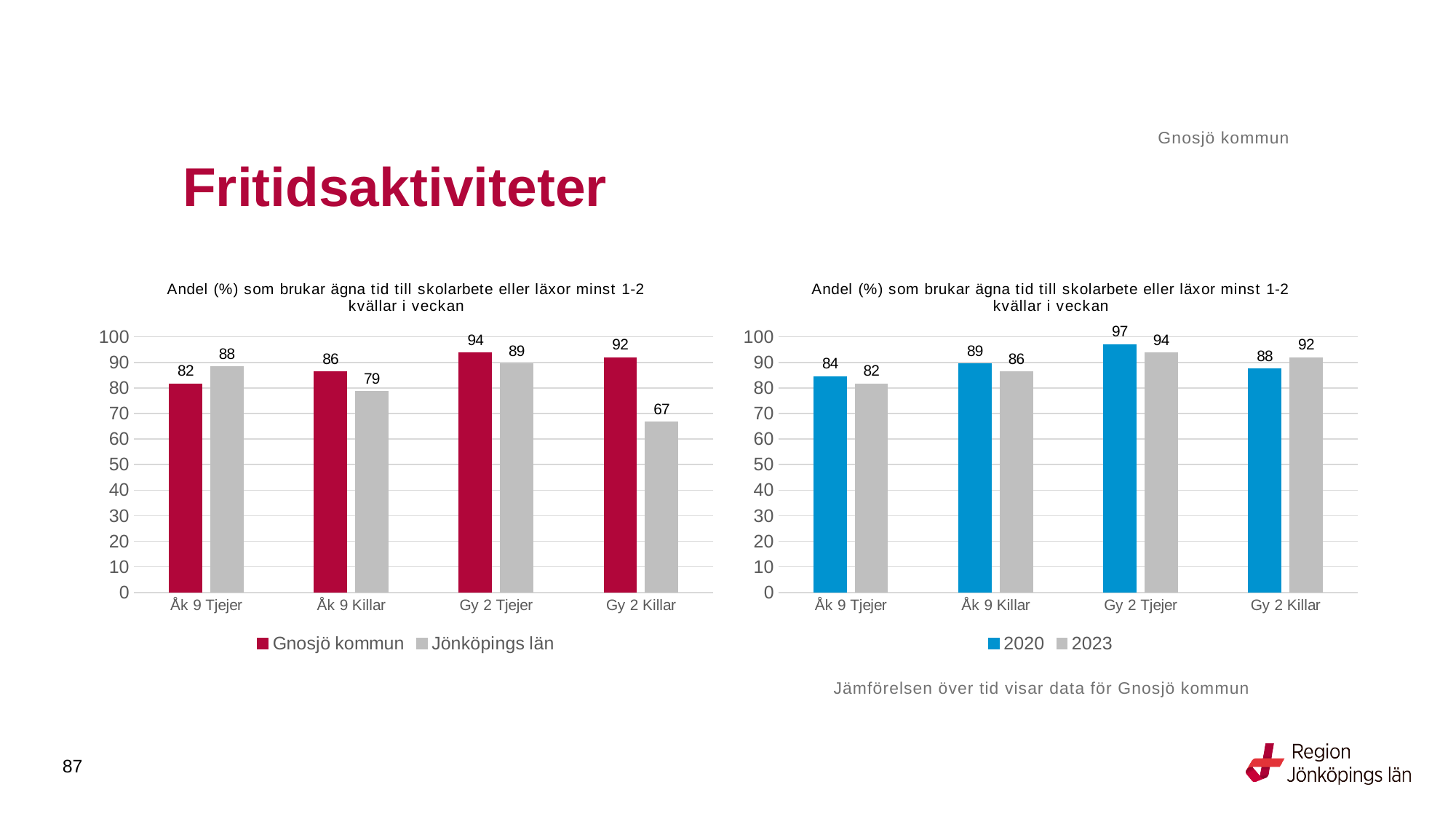
In the left chart, what is the value for Jönköpings län for Gy 2 Killar? 67 In the right chart, what is the value for 2023 for Åk 9 Killar? 86 How many categories are shown on the x axis of the right chart? 4 In the right chart, which category has the highest value for 2020? Gy 2 Tjejer How many series does the legend of the left chart list? 2 In the right chart, what is the value for 2020 for Gy 2 Tjejer? 97 In the left chart, which category has the lowest value for Jönköpings län? Gy 2 Killar In the left chart, what is the difference between Gnosjö kommun and Jönköpings län for Gy 2 Killar? 25 In the left chart, which is larger for Åk 9 Tjejer: Gnosjö kommun or Jönköpings län? Jönköpings län In the left chart, what is the value for Gnosjö kommun for Gy 2 Tjejer? 94 What type of chart is the right chart? Bar chart In the right chart, what is the difference between 2020 and 2023 for Gy 2 Killar? 4